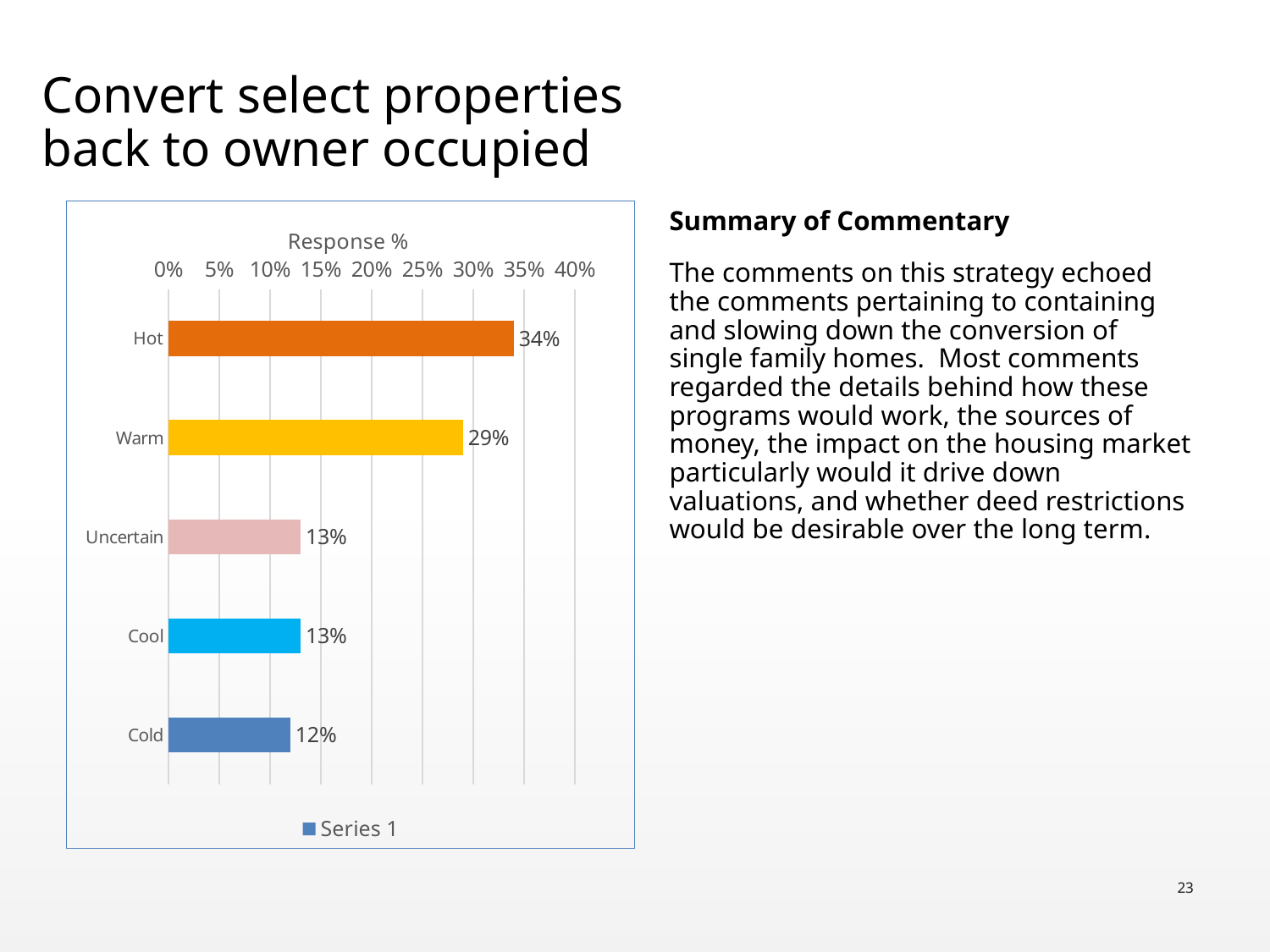
Which is larger, the value for Warm or the value for Uncertain? Warm What is the value for Cold? 12% Which category has the lowest value? Cold How many categories are shown in the chart? 5 What kind of chart is shown on the slide? bar chart What is the title of the chart? Response % What is the value for Warm? 29% What is the difference between the values for Hot and Warm? 5% Is the value for Hot greater or less than 30%? greater What is the difference between the values for Warm and Cold? 17% Which category has the highest value? Hot What is the value for Hot? 34%